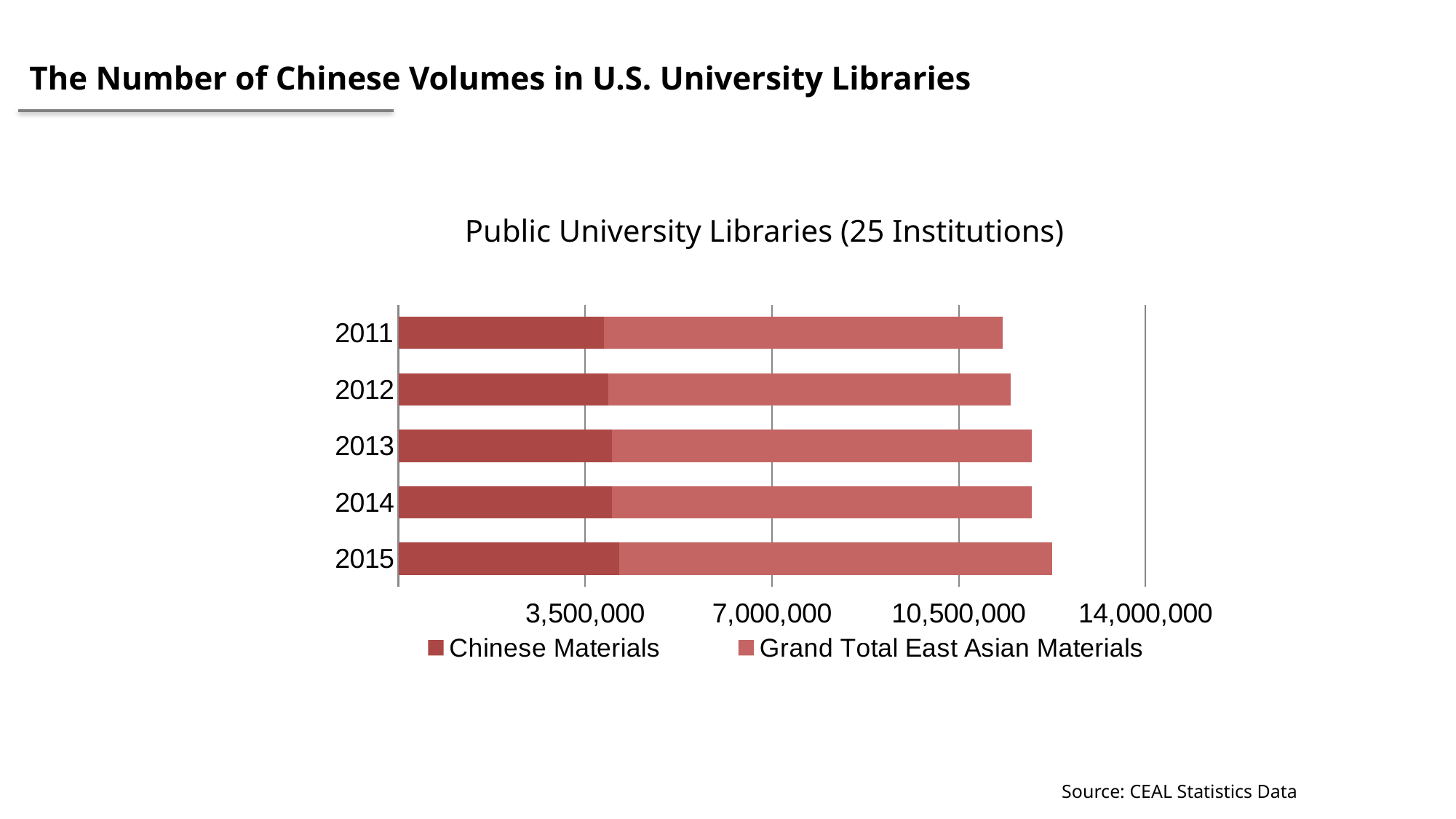
Which year has the longest total bar? 2015 Do the total bars generally rise or fall from 2011 to 2015? rise What kind of chart is shown on the slide? bar chart Is the total bar for 2015 larger or smaller than the total bar for 2011? larger Is the total bar for 2015 greater or less than 10,500,000? greater How many years are shown on the chart? 5 Which two series are listed in the legend? Chinese Materials and Grand Total East Asian Materials What is the title of the chart? Public University Libraries (25 Institutions) How many series does the legend list? 2 Is the Chinese Materials value for 2015 greater or less than 3,500,000? greater Is the total bar for 2015 greater or less than 14,000,000? less